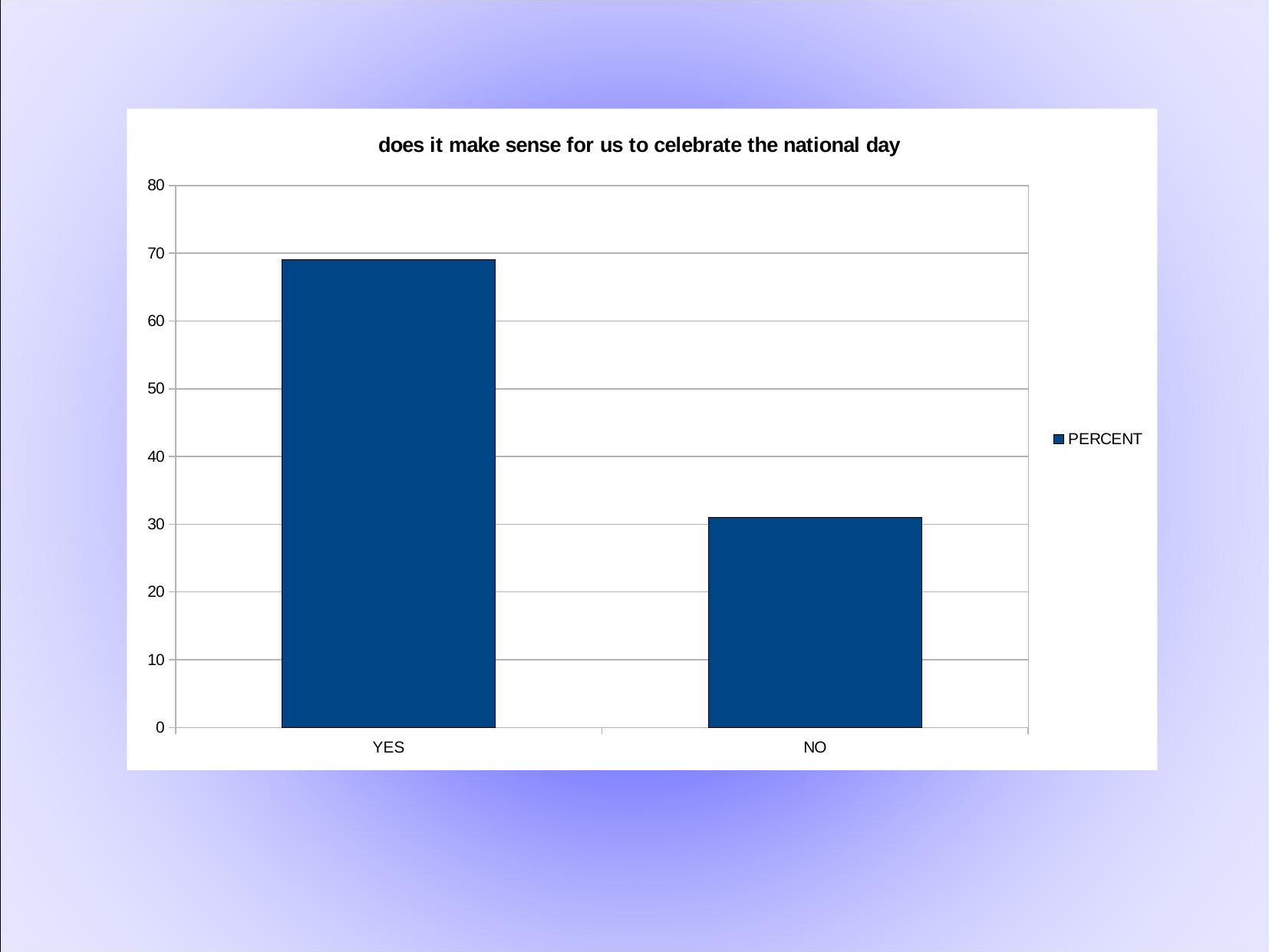
How many categories are shown on the x axis? 2 How many series does the legend list? 1 Which is larger, the value for YES or the value for NO? YES Which category has the highest value? YES What is the title of the chart? does it make sense for us to celebrate the national day What kind of chart is shown on the slide? bar chart Which category has the lowest value? NO What is the name of the series in the legend? PERCENT Is the value for NO greater or less than 40? less Is the value for YES greater or less than 60? greater